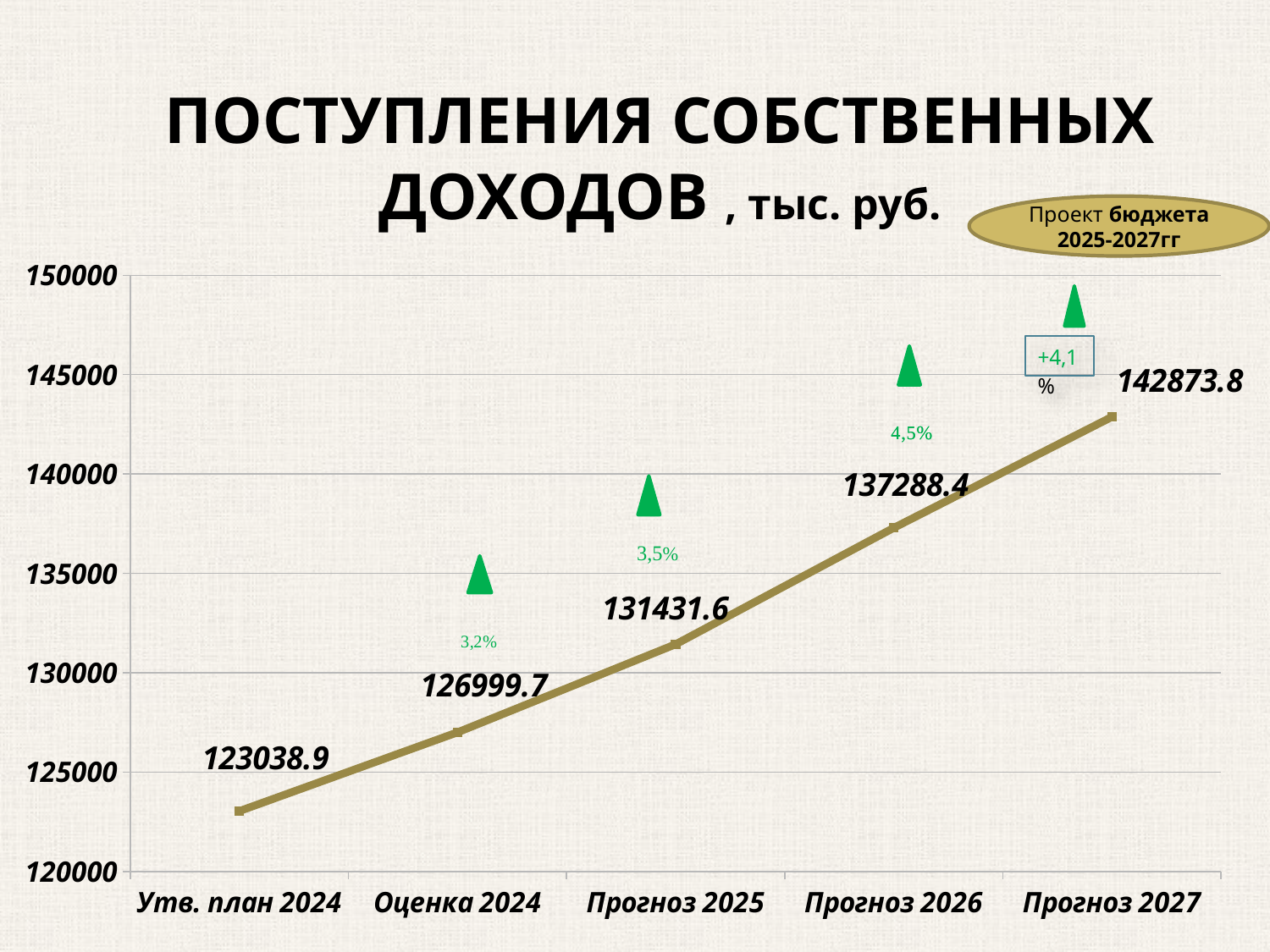
Which category has the lowest value? Утв. план 2024 What is the value for Утв. план 2024? 123038.9 Which category has the highest value? Прогноз 2027 How many categories are shown on the x axis? 5 What kind of chart is shown on the slide? line chart What is the difference between the values for Оценка 2024 and Утв. план 2024? 3960.8 Do the values rise or fall from Утв. план 2024 to Прогноз 2027? rise What is the value for Оценка 2024? 126999.7 What is the difference between the values for Прогноз 2027 and Прогноз 2026? 5585.4 Which is larger, the value for Прогноз 2025 or the value for Оценка 2024? Прогноз 2025 Is the value for Прогноз 2025 greater or less than 130000? greater What is the value for Прогноз 2026? 137288.4